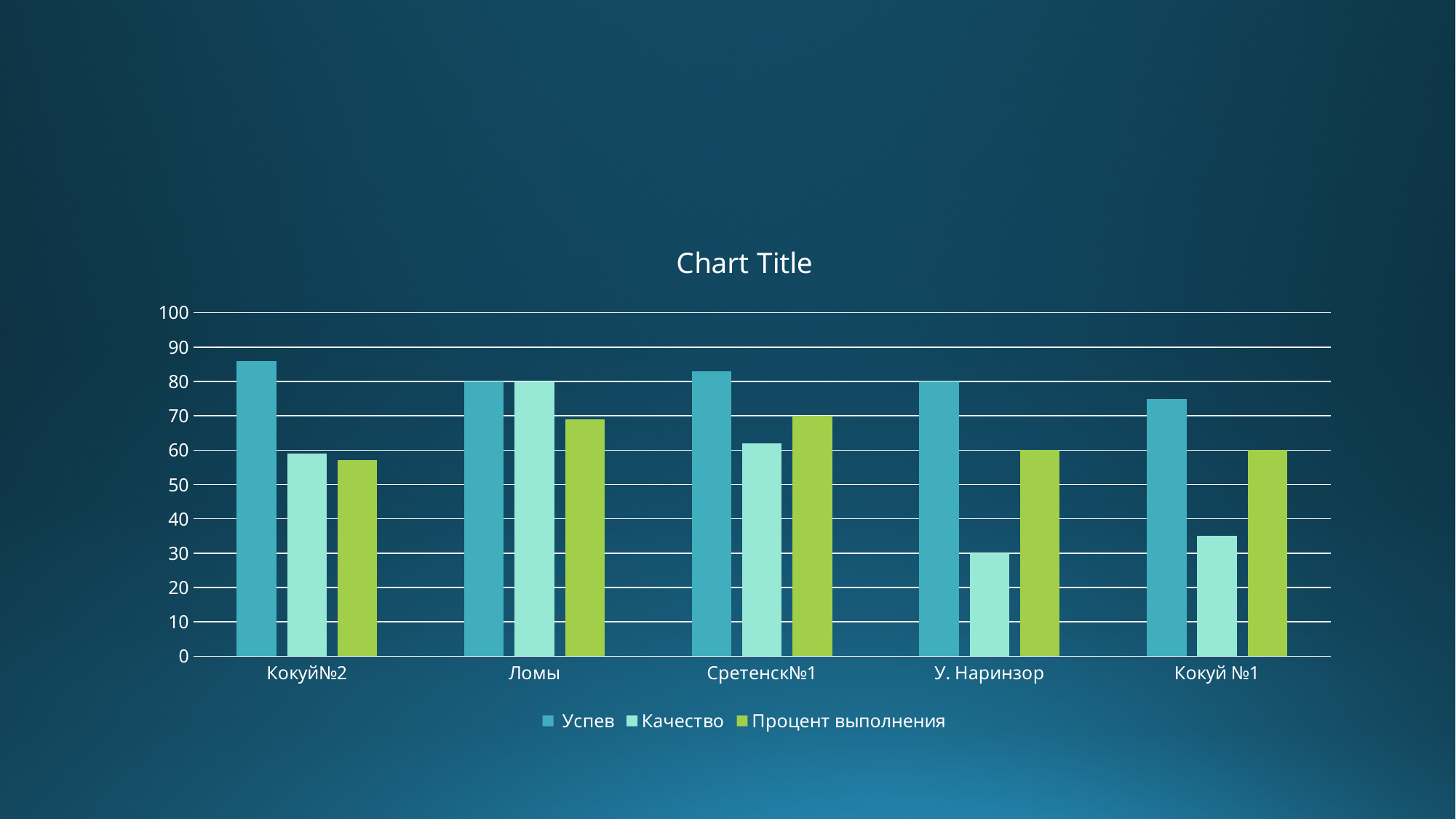
Which category has the lowest value for Качество? У. Наринзор Is the value of Успев for Кокуй №1 greater or less than 70? greater What is the title of the chart? Chart Title Which is larger, the Успев value for Кокуй№2 or for Кокуй №1? Кокуй№2 What is the value of Успев for Ломы? 80 Which category has the highest value for Качество? Ломы What is the value of Процент выполнения for У. Наринзор? 60 How many series does the legend list? 3 Is the value of Процент выполнения for Кокуй№2 greater or less than 60? less Which series is shown in green in the legend? Процент выполнения What kind of chart is shown on the slide? Bar chart How many categories are shown on the x axis? 5